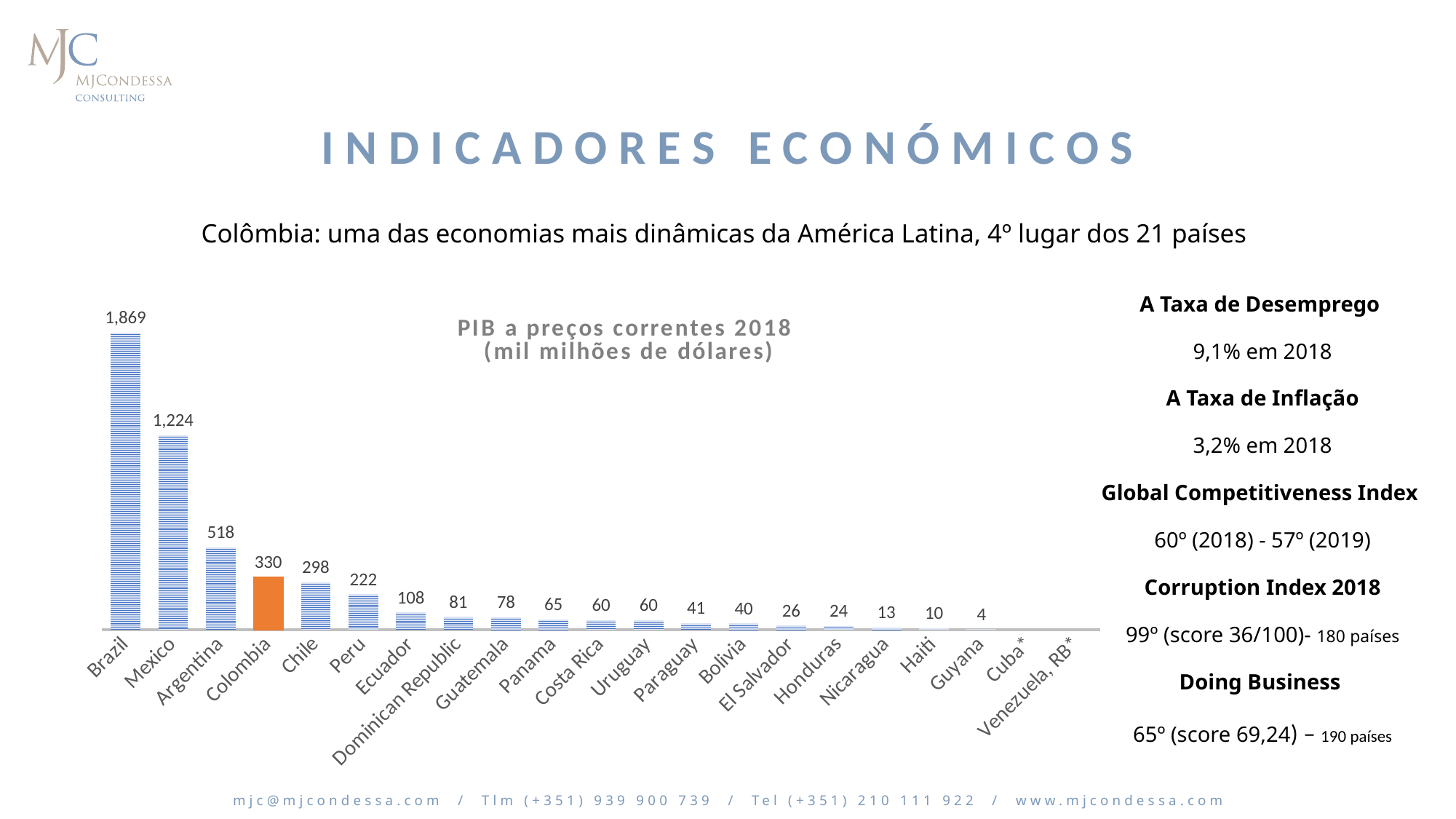
What is the difference between the values for Brazil and Mexico in the chart 'PIB a preços correntes 2018'? 645 Do the values in the chart 'PIB a preços correntes 2018' rise or fall from left to right along the x axis? Fall Which country's bar is highlighted in orange in the chart 'PIB a preços correntes 2018'? Colombia How many countries are shown on the x axis of the chart 'PIB a preços correntes 2018'? 21 What is the difference between the values for Colombia and Chile in the chart 'PIB a preços correntes 2018'? 32 What is the value for Honduras in the chart 'PIB a preços correntes 2018'? 24 Which has a larger value in the chart 'PIB a preços correntes 2018', Argentina or Peru? Argentina What is the value for Dominican Republic in the chart 'PIB a preços correntes 2018'? 81 What kind of chart is 'PIB a preços correntes 2018'? Bar chart What is the value for Brazil in the chart 'PIB a preços correntes 2018'? 1,869 What is the value for Colombia in the chart 'PIB a preços correntes 2018'? 330 Which country has the highest value in the chart 'PIB a preços correntes 2018'? Brazil